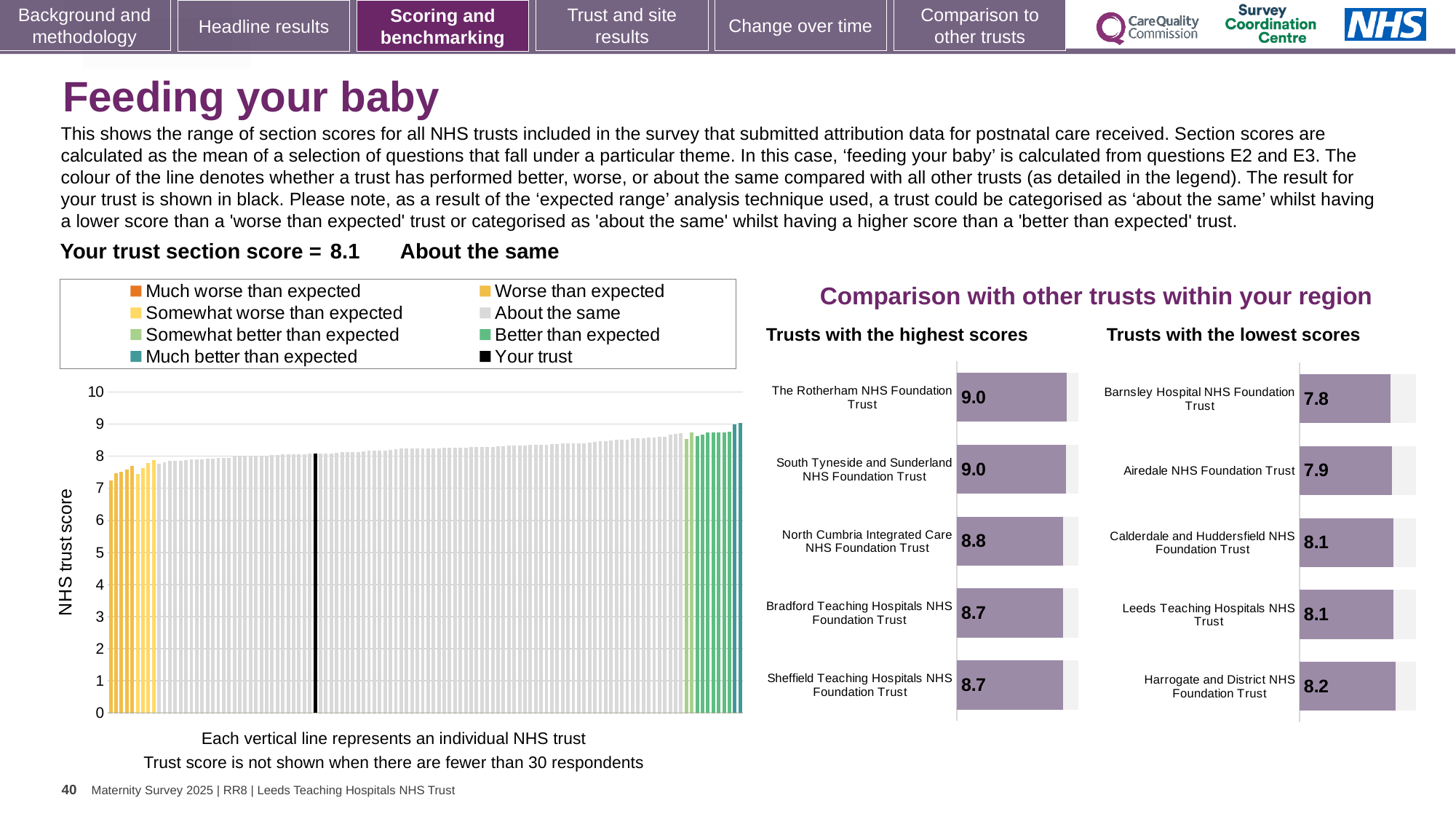
In the 'Trusts with the highest scores' chart, what is the difference between the score for The Rotherham NHS Foundation Trust and the score for Sheffield Teaching Hospitals NHS Foundation Trust? 0.3 How many entries does the legend above the large chart on the left list? 8 In the 'Trusts with the lowest scores' chart, what is the score for Airedale NHS Foundation Trust? 7.9 In the 'Trusts with the lowest scores' chart, what is the difference between the score for Harrogate and District NHS Foundation Trust and the score for Barnsley Hospital NHS Foundation Trust? 0.4 In the large chart on the left showing all NHS trusts, do the bar values rise or fall from left to right? rise In the large chart on the left showing all NHS trusts, is the value of the lowest bar greater or less than 7? greater In the 'Trusts with the highest scores' chart, what is the score for North Cumbria Integrated Care NHS Foundation Trust? 8.8 How many trusts are shown in the 'Trusts with the lowest scores' chart? 5 In the 'Trusts with the lowest scores' chart, which trust has the lowest score? Barnsley Hospital NHS Foundation Trust In the 'Trusts with the highest scores' chart, which has the higher score: North Cumbria Integrated Care NHS Foundation Trust or Bradford Teaching Hospitals NHS Foundation Trust? North Cumbria Integrated Care NHS Foundation Trust What kind of chart is the large chart on the left showing all NHS trusts? bar chart In the 'Trusts with the lowest scores' chart, which trust has the highest score? Harrogate and District NHS Foundation Trust